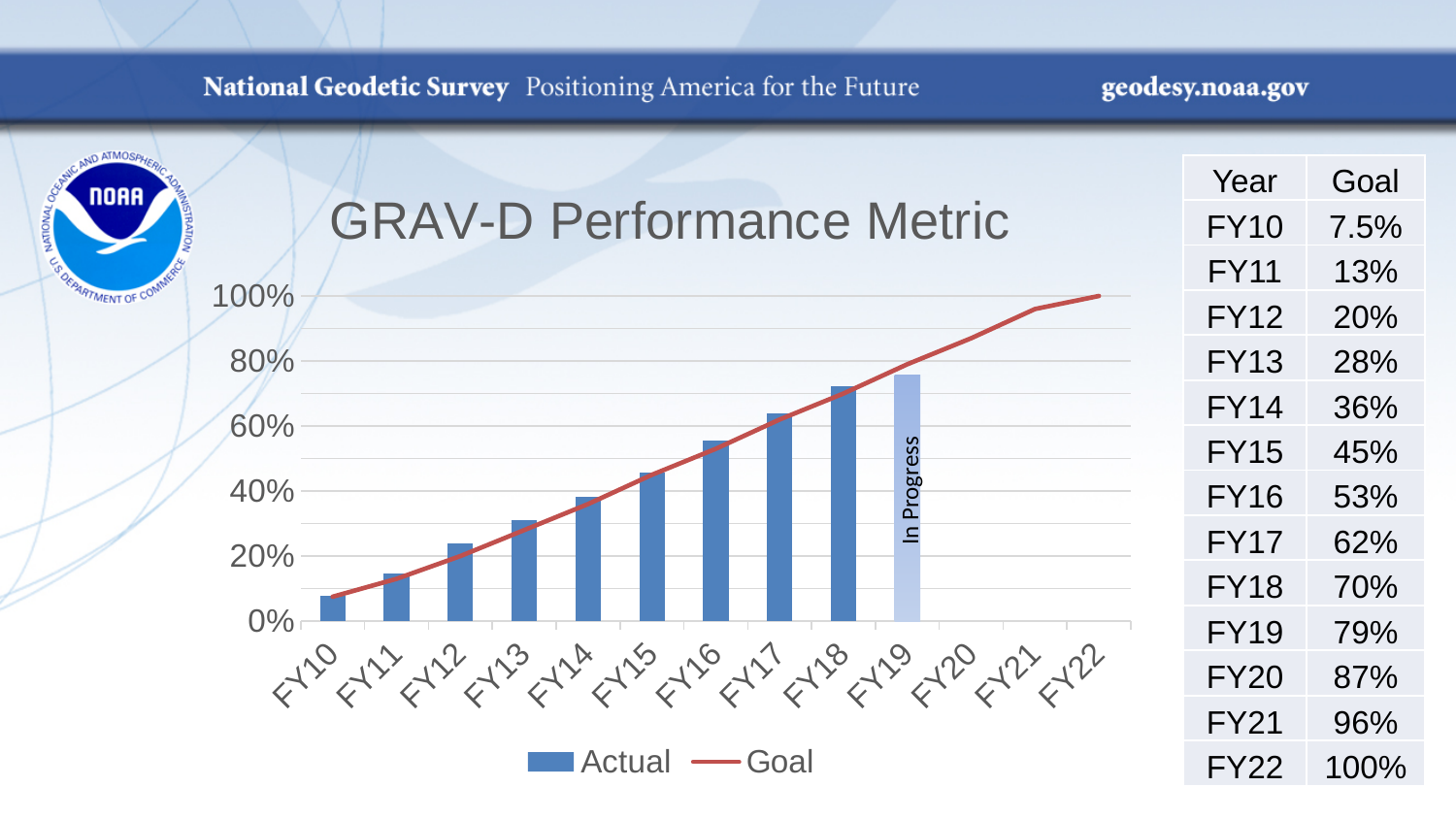
What kind of chart is the GRAV-D Performance Metric chart? bar chart with a line How many fiscal years are shown along the x axis of the GRAV-D Performance Metric chart? 13 Does the Goal line rise or fall from FY10 to FY22? rises What is the difference between the Goal for FY22 and the Goal for FY10 in the table? 92.5% Which fiscal year's bar is labeled "In Progress"? FY19 How many series does the legend of the GRAV-D Performance Metric chart list? 2 Which fiscal year has the lowest Actual bar? FY10 Which is larger, the Actual value for FY17 or the Actual value for FY14? FY17 Is the Actual value for FY18 greater or less than 60%? greater According to the Goal table, what is the Goal value for FY15? 45% According to the Goal table, what is the Goal value for FY22? 100% Is the Actual value for FY12 greater or less than 40%? less